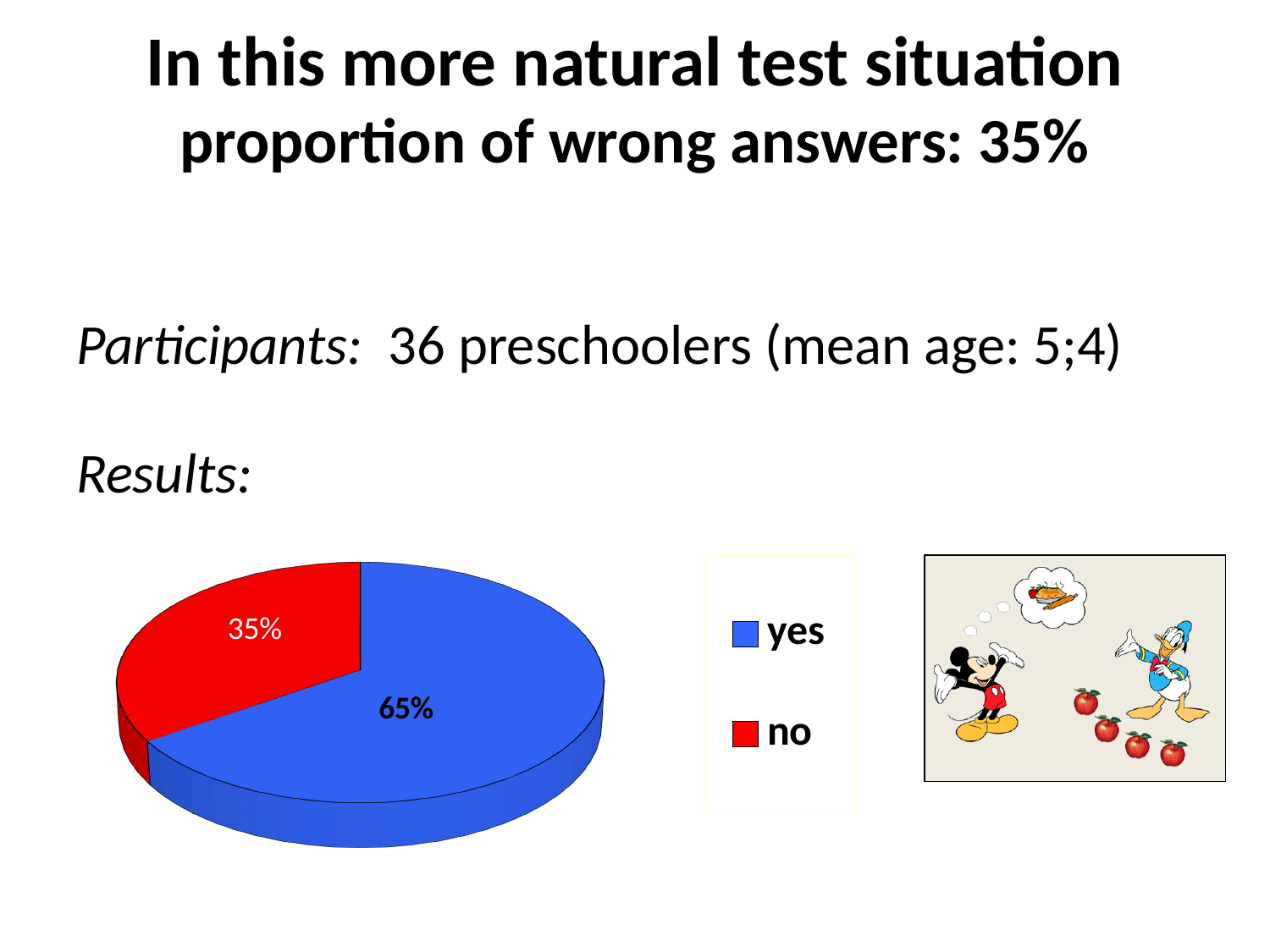
What kind of chart is shown on the slide? pie chart How many slices does the pie chart have? 2 What colour is the "no" slice in the pie chart? red Which slice of the pie is the smallest? no What share of the pie does the "no" slice represent? 35% Is the share of the "no" slice greater or less than 50%? less Which is larger, the "yes" slice or the "no" slice? yes What is the difference in percentage points between the "yes" and "no" slices? 30% Which slice of the pie is the largest? yes How many entries does the legend list? 2 What colour is the "yes" slice in the pie chart? blue What share of the pie does the "yes" slice represent? 65%